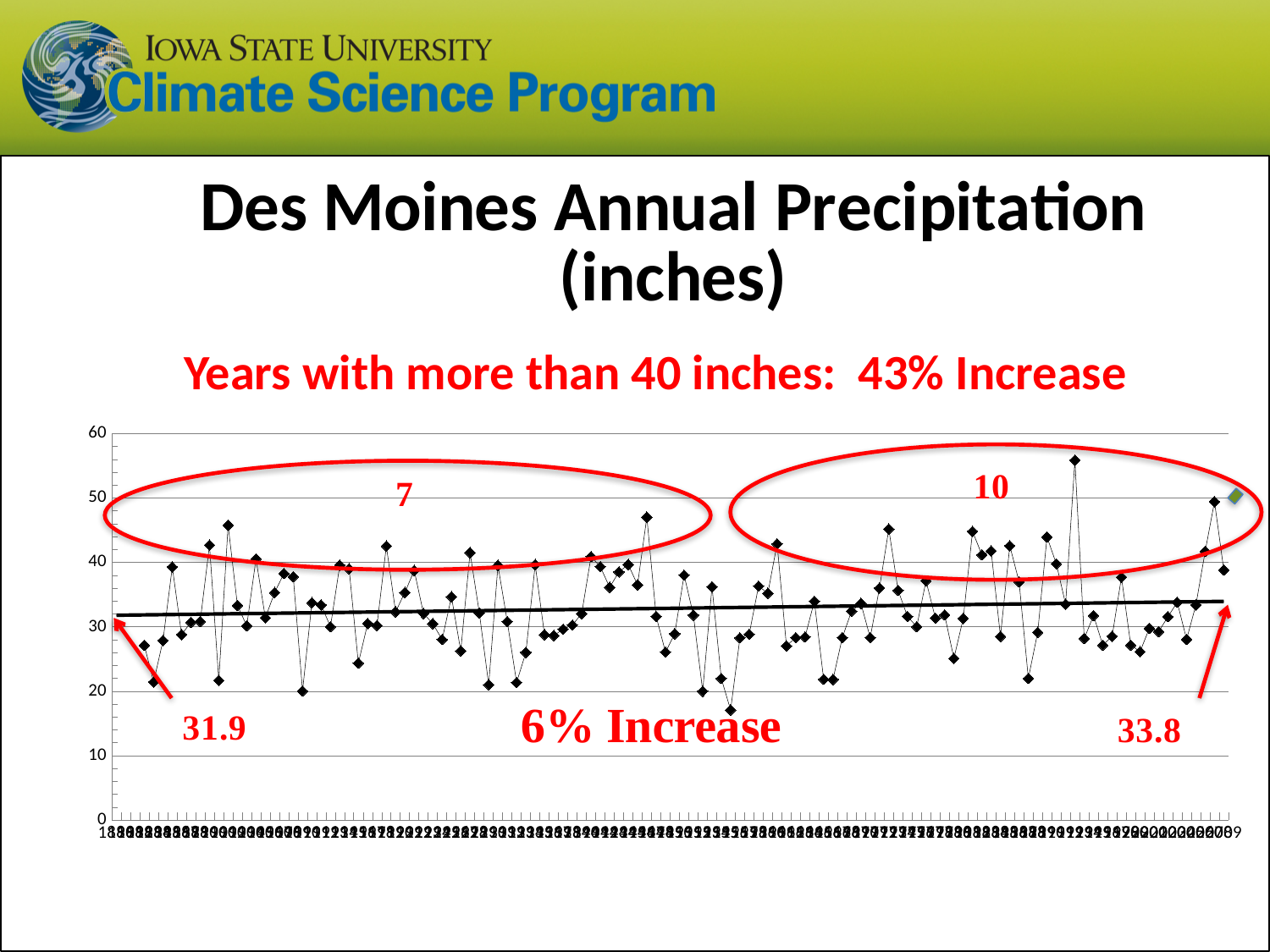
What value is labelled at the left (start) end of the trend line? 31.9 Does the trend line rise or fall from left to right across the years? rises Is the lowest annual precipitation value plotted greater or less than 20? less Which labelled trend-line value is larger, the start value or the end value? the end value (33.8) By how much does the labelled end value of the trend line (33.8) exceed the labelled start value (31.9)? 1.9 Is the highest annual precipitation value plotted greater or less than 50? greater What kind of chart is shown on the slide? line chart How many years with more than 40 inches are counted in the left circled period? 7 What value is labelled at the right (end) end of the trend line? 33.8 What is the title of the chart? Des Moines Annual Precipitation (inches) How many years with more than 40 inches are counted in the right circled period? 10 What percentage increase is annotated on the trend line? 6% Increase